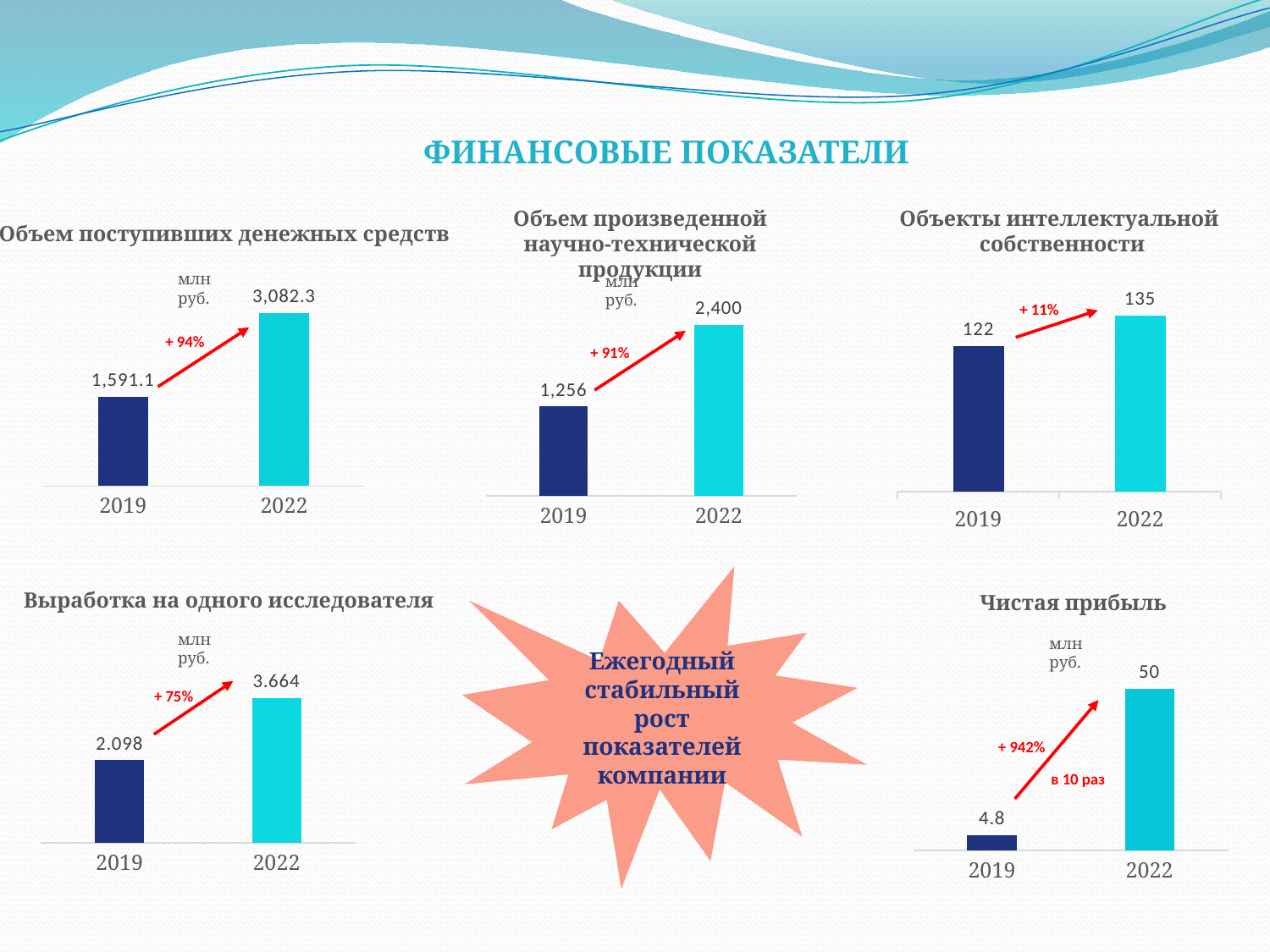
In the chart titled "Чистая прибыль", what is the value for 2019? 4.8 In the chart titled "Объем поступивших денежных средств", what is the value for 2022? 3,082.3 In the chart titled "Выработка на одного исследователя", what is the difference between the 2022 and 2019 values? 1.566 In the chart titled "Чистая прибыль", which year has the higher value, 2019 or 2022? 2022 How many bars are plotted in the chart titled "Объем произведенной научно-технической продукции"? 2 What kind of chart is the one titled "Чистая прибыль"? bar chart In the chart titled "Объем поступивших денежных средств", which year has the lowest value? 2019 In the chart titled "Объекты интеллектуальной собственности", what is the value for 2022? 135 What percentage growth is annotated on the chart titled "Объем произведенной научно-технической продукции"? + 91% In the chart titled "Объем произведенной научно-технической продукции", what is the value for 2019? 1,256 In the chart titled "Выработка на одного исследователя", do the values rise or fall from 2019 to 2022? rise In the chart titled "Объекты интеллектуальной собственности", what is the difference between the 2022 and 2019 values? 13